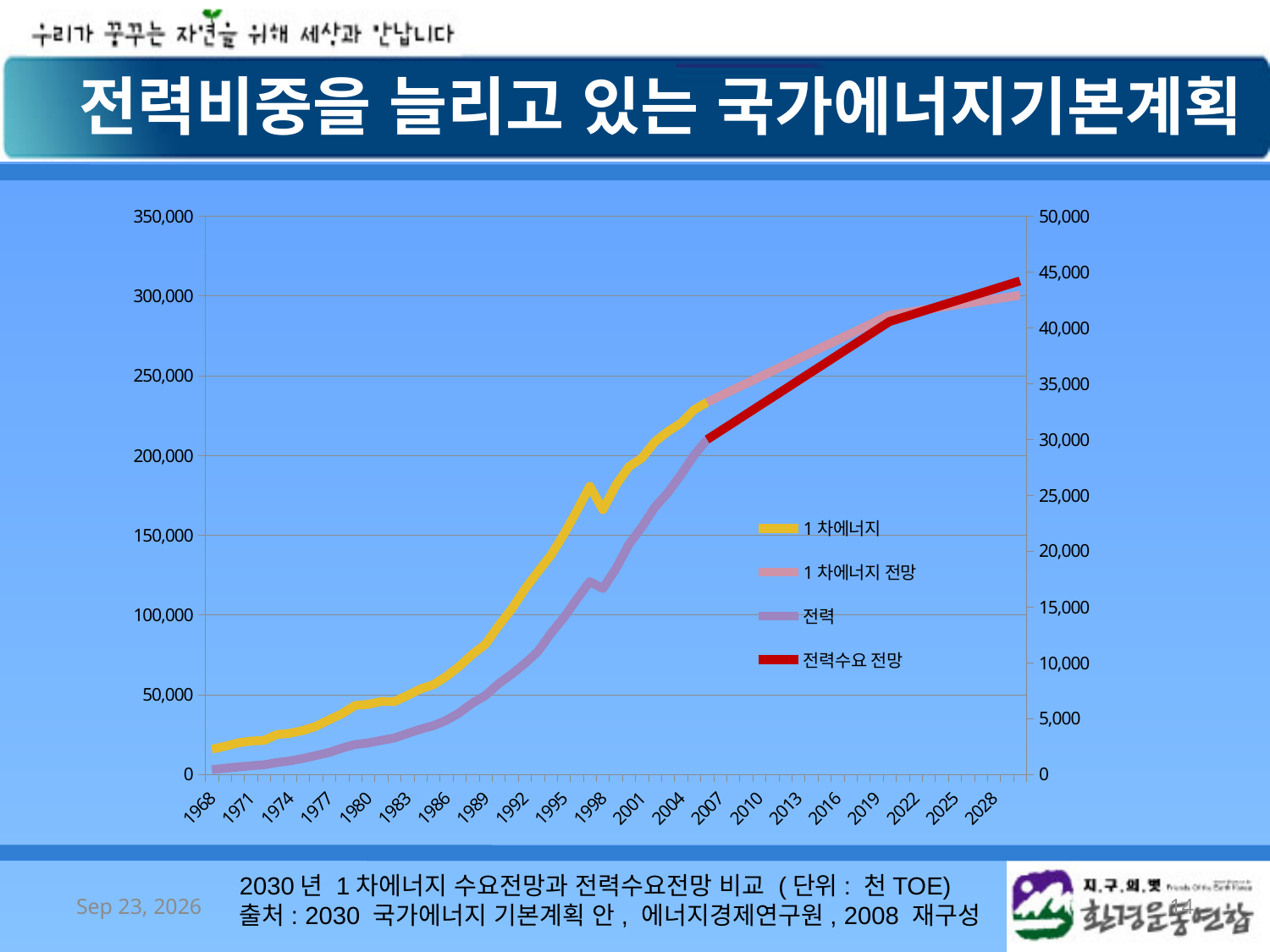
Is the 1차에너지 value for 2004, read on the left axis, greater or less than 200,000? greater What is the maximum value shown on the left vertical axis of the chart? 350,000 Does the 1차에너지 series generally rise or fall from 1968 to 2007? Rise Is the 1차에너지 value for 1968, read on the left axis, greater or less than 50,000? less What is the first year labelled on the x axis of the chart? 1968 What is the maximum value shown on the right vertical axis of the chart? 50,000 Which series is drawn in red in the chart? 전력수요 전망 How many series does the chart legend list? 4 Which series is drawn in yellow in the chart? 1차에너지 Does the 전력수요 전망 series rise or fall from 2007 to 2030? Rise What kind of chart is shown on the slide? Line chart Which line is plotted higher on the chart in 1995, 1차에너지 or 전력? 1차에너지